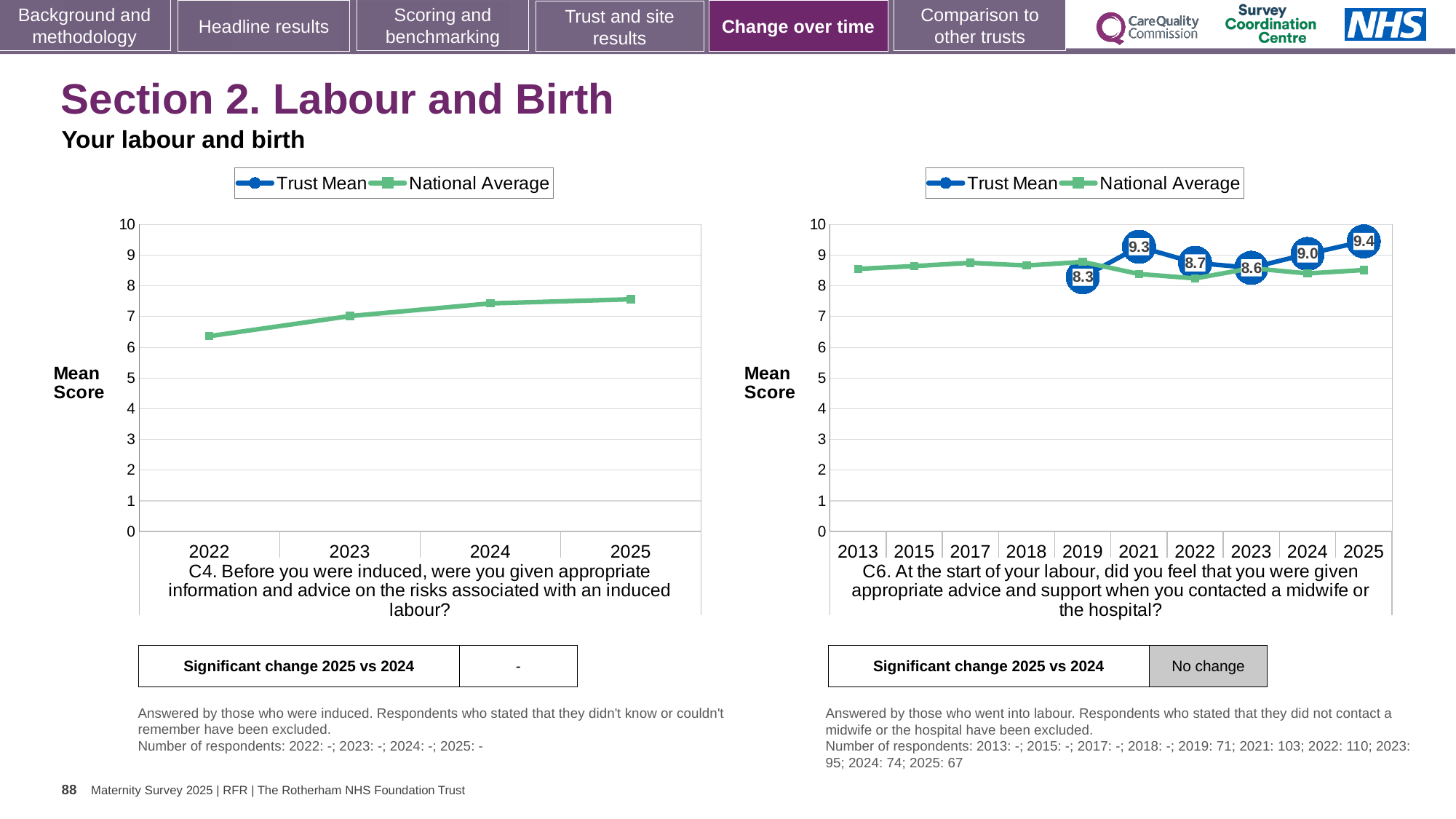
In the C4 chart on the left, does the National Average rise or fall from 2022 to 2025? rise What type of chart is the C4 chart on the left? line chart In the C6 chart on the right, which year has the lowest labelled Trust Mean? 2019 In the C6 chart on the right, what is the Trust Mean for 2022? 8.7 In the C4 chart on the left, is the National Average for 2022 greater or less than 7? less In the C6 chart on the right, what is the Trust Mean for 2025? 9.4 In the C6 chart on the right, is the National Average for 2013 greater or less than 8? greater In the C6 chart on the right, is the Trust Mean higher in 2021 or in 2023? 2021 In the C6 chart on the right, what is the Trust Mean for 2019? 8.3 How many years are shown on the x axis of the C6 chart on the right? 10 In the C6 chart on the right, what is the difference between the Trust Mean for 2025 and 2024? 0.4 In the C6 chart on the right, which year has the highest Trust Mean? 2025